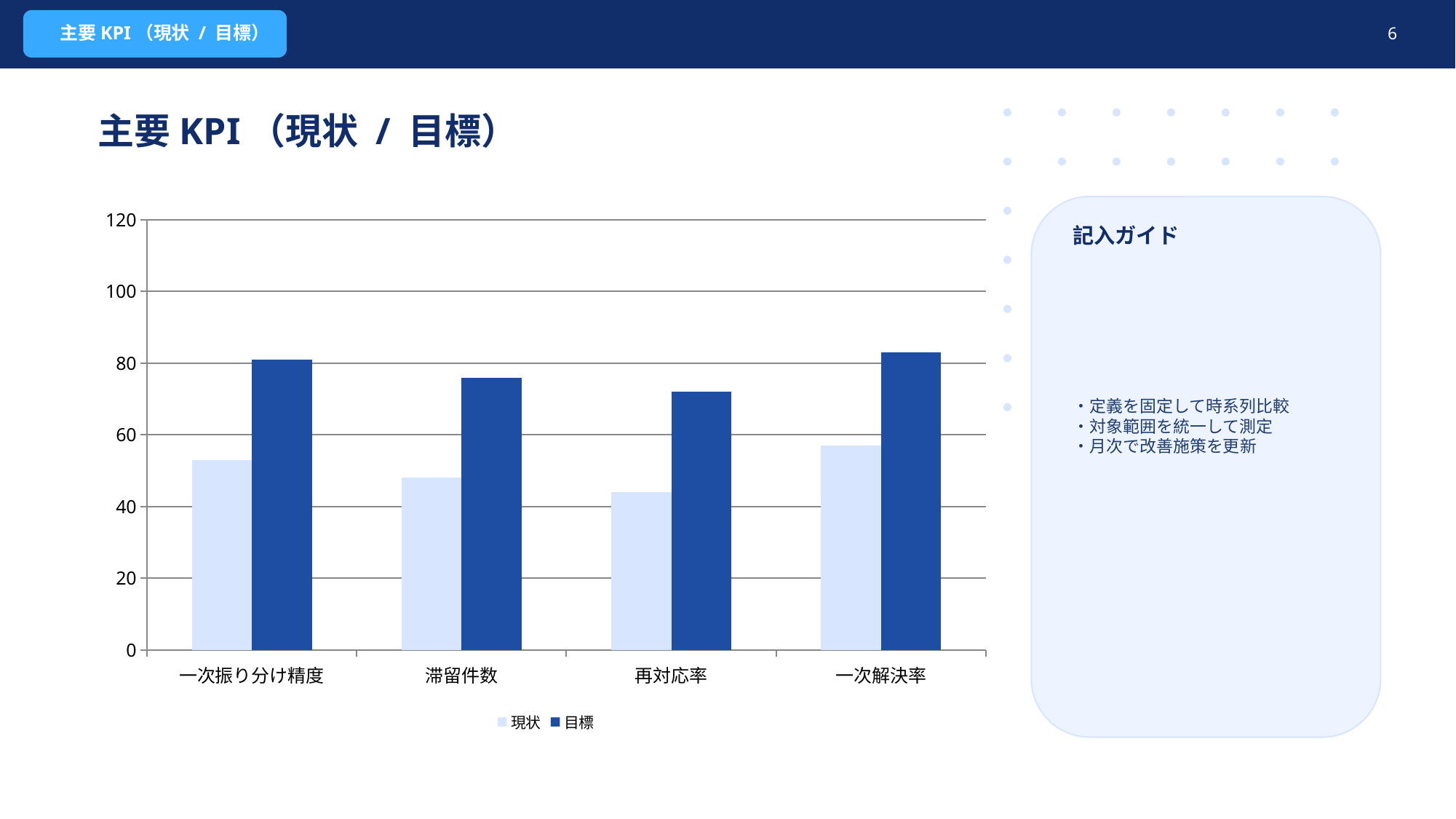
Which category has the lowest 現状 value? 再対応率 Is the 目標 value for 再対応率 greater or less than 60? greater Is the 目標 value for 滞留件数 greater or less than 80? less How many series does the chart's legend list? 2 Is the 現状 value for 一次解決率 greater or less than 40? greater What kind of chart is shown on the slide? bar chart What is the title of the chart slide? 主要 KPI （現状 / 目標） Which category has the highest 現状 value? 一次解決率 How many categories are shown on the x axis of the chart? 4 Which category has the lowest 目標 value? 再対応率 For 滞留件数, which is larger: the 現状 value or the 目標 value? 目標